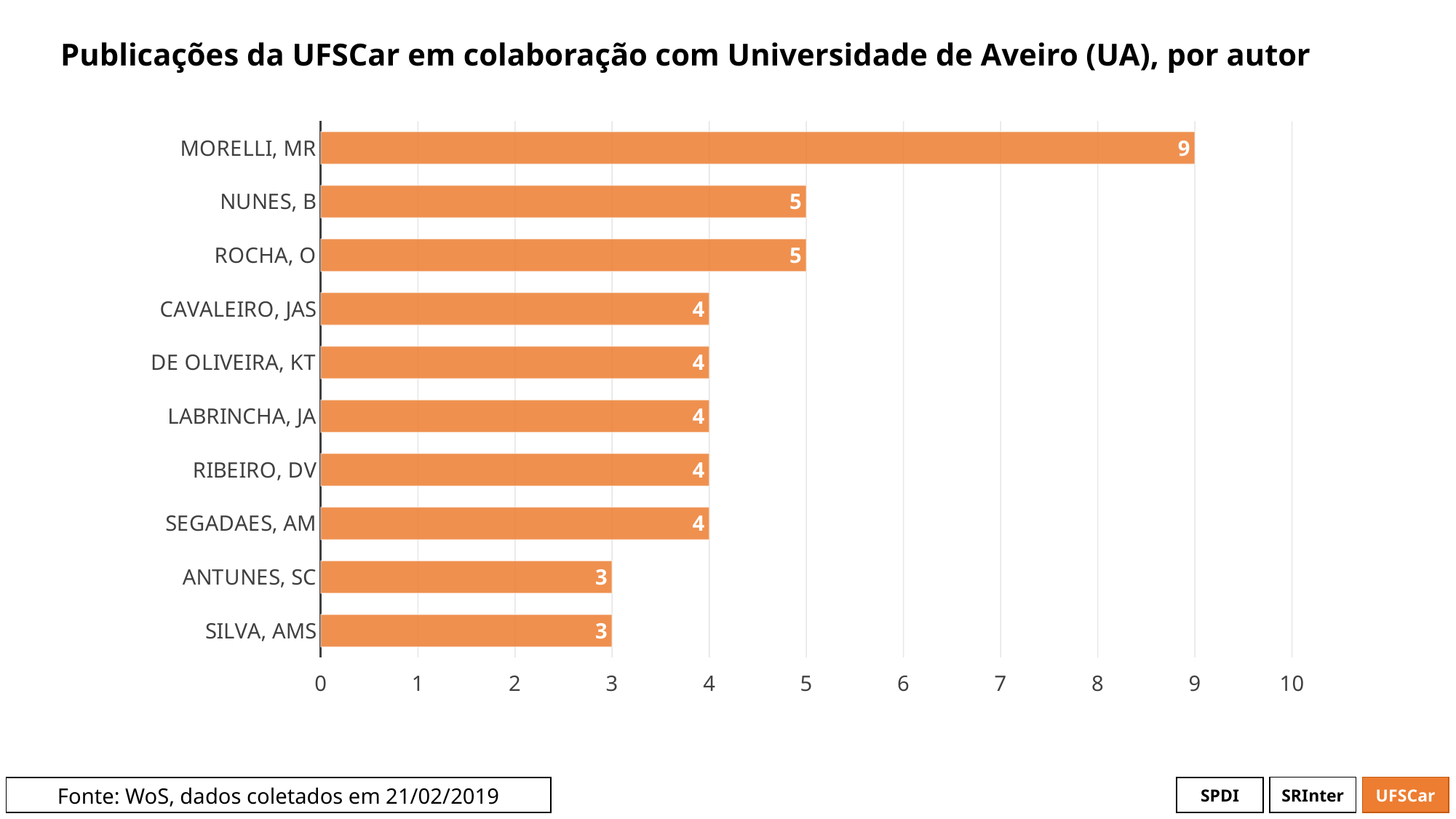
Is the value for MORELLI, MR greater or less than 8? greater How many authors are shown in the chart? 10 How many authors have a value of 4? 5 What is the difference between the values for MORELLI, MR and NUNES, B? 4 What is the title of the chart? Publicações da UFSCar em colaboração com Universidade de Aveiro (UA), por autor What is the difference between the values for ROCHA, O and ANTUNES, SC? 2 What kind of chart is shown on the slide? bar chart Which author has the highest number of publications? MORELLI, MR What is the value for SILVA, AMS? 3 How many publications does MORELLI, MR have? 9 What is the value for CAVALEIRO, JAS? 4 Which is larger, the value for NUNES, B or the value for RIBEIRO, DV? NUNES, B